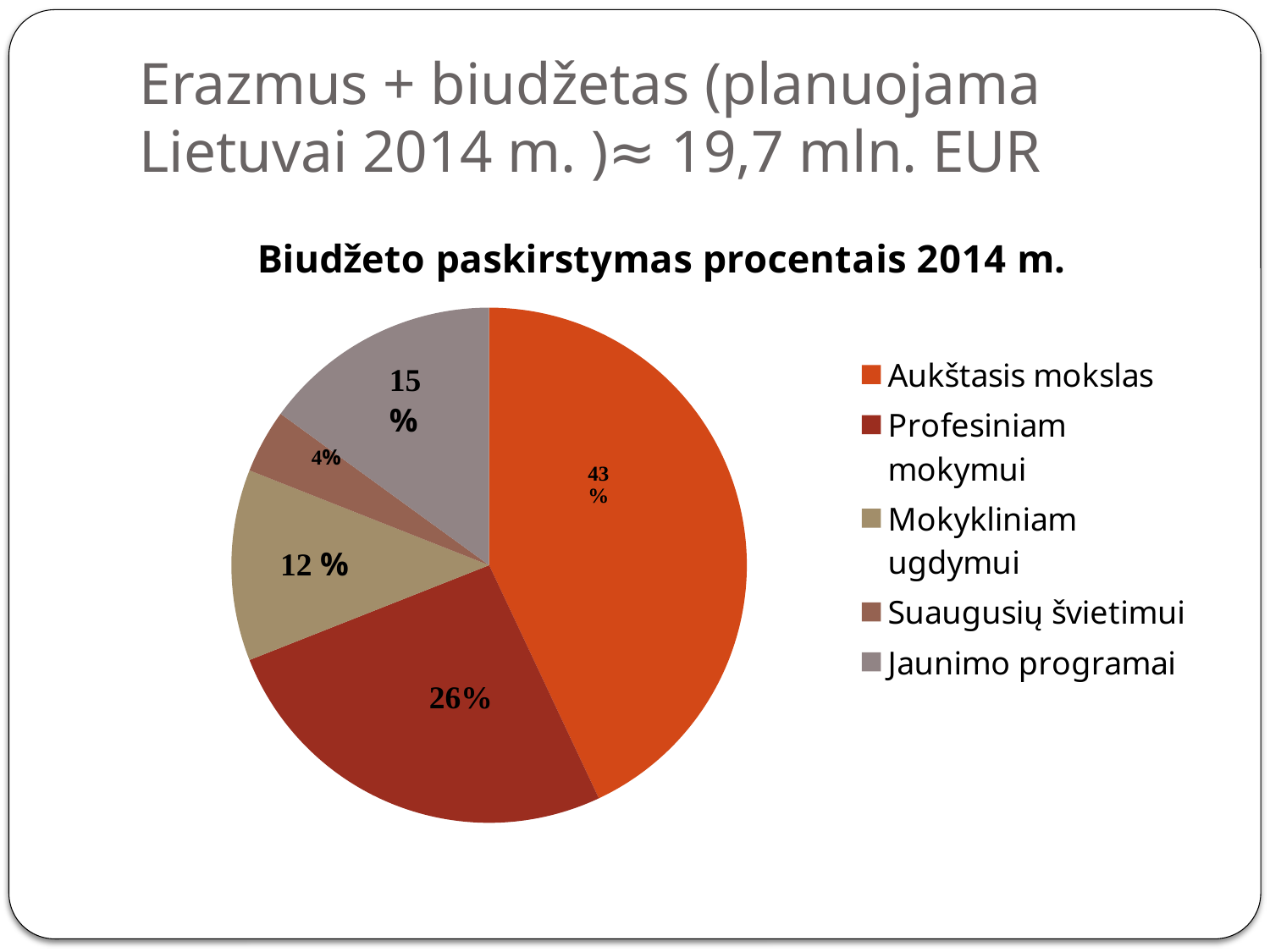
What share of the budget goes to Mokykliniam ugdymui? 12% Which has a larger share, Jaunimo programai or Mokykliniam ugdymui? Jaunimo programai What is the title of the chart? Biudžeto paskirstymas procentais 2014 m. Which category has the smallest share of the budget? Suaugusių švietimui What share of the budget goes to Aukštasis mokslas? 43% Which category has the largest share of the budget? Aukštasis mokslas How many categories does the legend list? 5 What share of the budget goes to Suaugusių švietimui? 4% What kind of chart is shown on the slide? pie chart What share of the budget goes to Jaunimo programai? 15% What is the difference in percentage points between Aukštasis mokslas and Profesiniam mokymui? 17 What share of the budget goes to Profesiniam mokymui? 26%